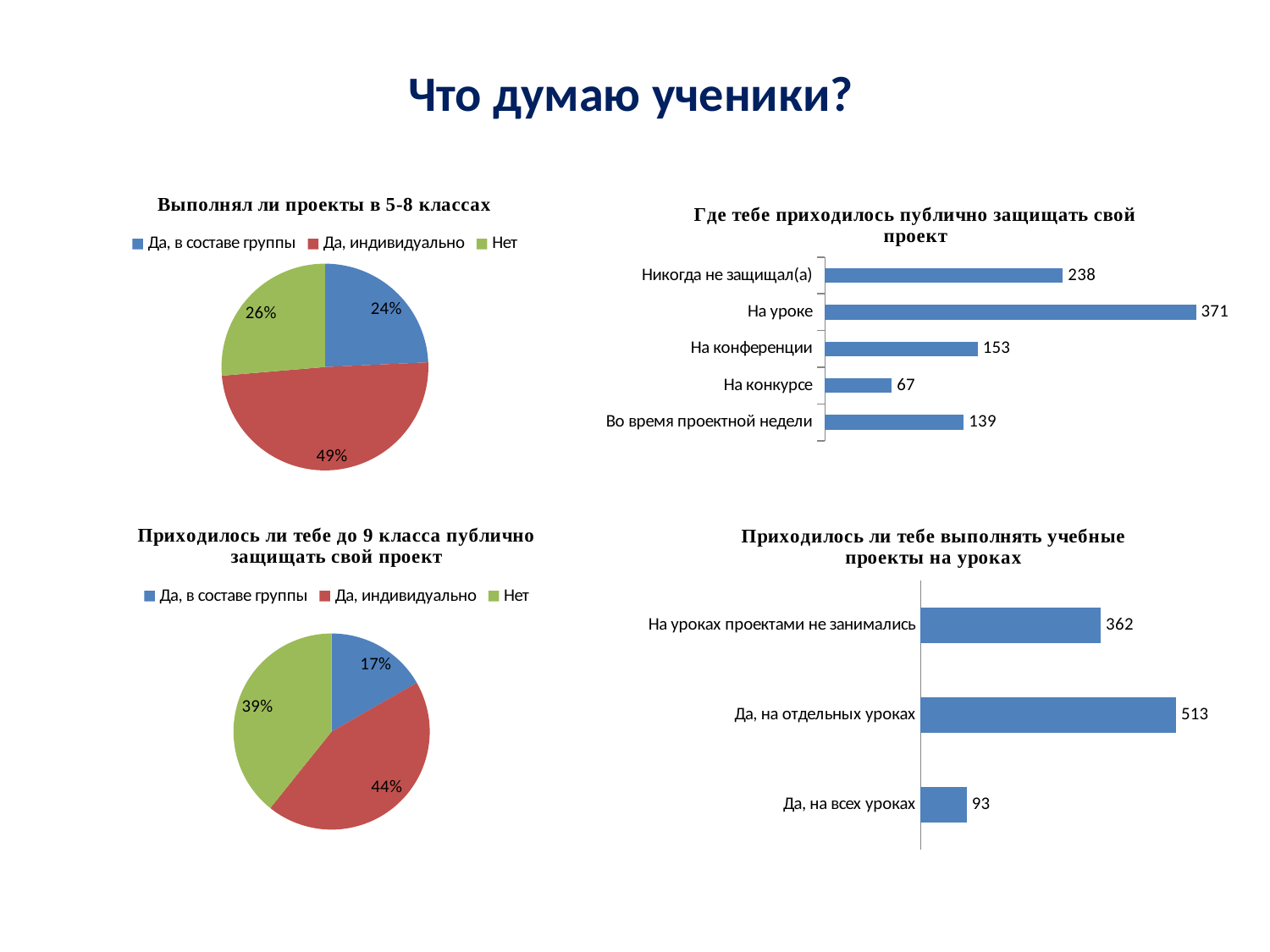
In the chart 'Выполнял ли проекты в 5-8 классах', which answer has the smallest share? Да, в составе группы In the chart 'Приходилось ли тебе выполнять учебные проекты на уроках', which is larger: 'На уроках проектами не занимались' or 'Да, на отдельных уроках'? Да, на отдельных уроках In the chart 'Приходилось ли тебе выполнять учебные проекты на уроках', what is the value for 'Да, на всех уроках'? 93 How many categories are shown in the chart 'Где тебе приходилось публично защищать свой проект'? 5 In the chart 'Выполнял ли проекты в 5-8 классах', what share of respondents answered 'Да, индивидуально'? 49% What kind of chart is 'Выполнял ли проекты в 5-8 классах'? Pie chart In the chart 'Приходилось ли тебе до 9 класса публично защищать свой проект', what share answered 'Нет'? 39% In the chart 'Приходилось ли тебе до 9 класса публично защищать свой проект', which answer has the largest share? Да, индивидуально In the chart 'Где тебе приходилось публично защищать свой проект', what is the value for 'На уроке'? 371 How many entries does the legend of the chart 'Приходилось ли тебе до 9 класса публично защищать свой проект' list? 3 In the chart 'Где тебе приходилось публично защищать свой проект', which category has the lowest value? На конкурсе In the chart 'Где тебе приходилось публично защищать свой проект', what is the difference between 'Никогда не защищал(а)' and 'На конференции'? 85